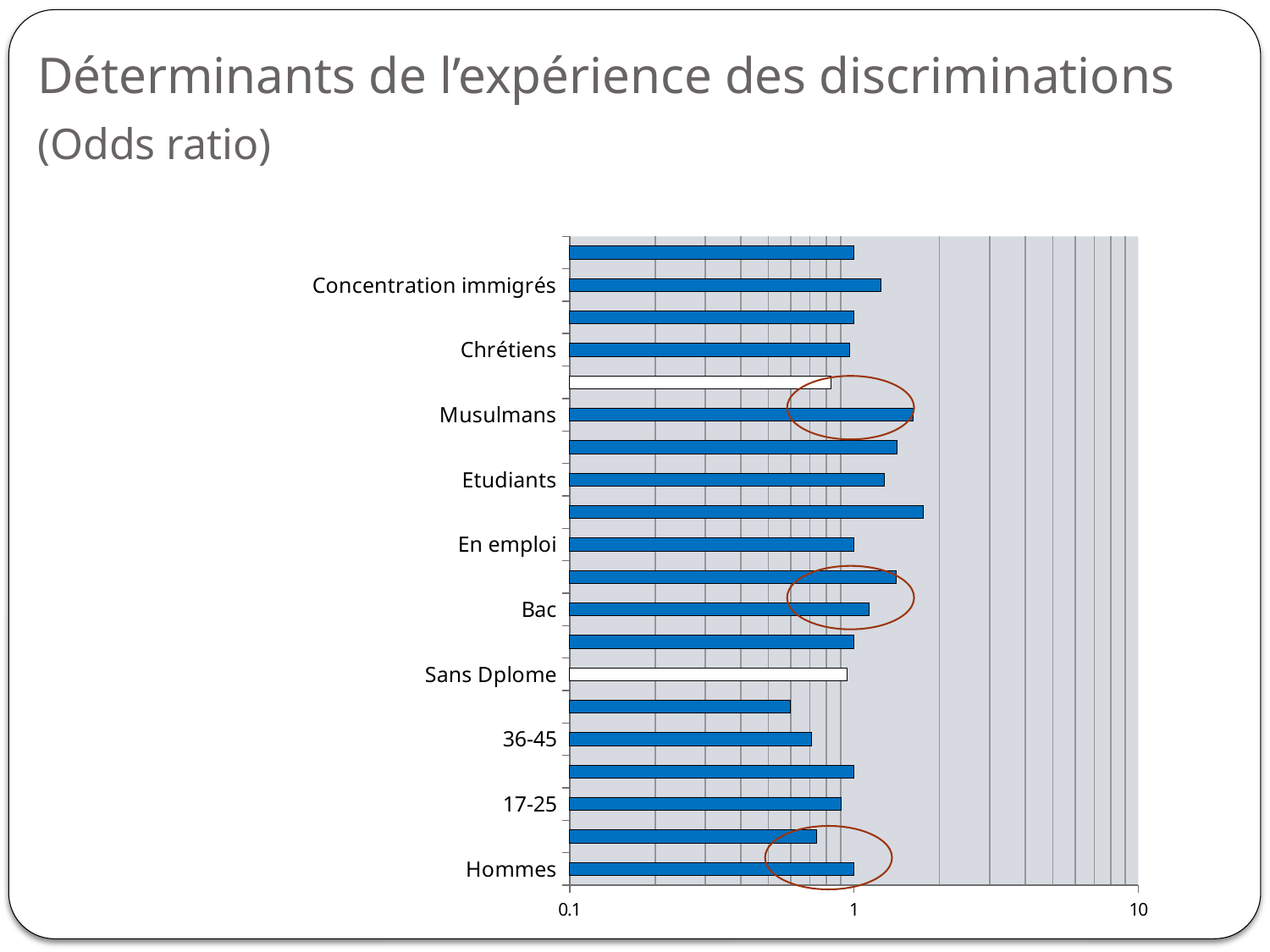
Is the value for Concentration immigrés greater or less than 1? greater Which has the larger value, Etudiants or 36-45? Etudiants What kind of chart is shown on the slide? bar chart Among the labelled categories, which has the lowest value? 36-45 Among the labelled categories, which has the highest value? Musulmans Is the value for Etudiants greater or less than 1? greater What is the maximum value shown on the horizontal axis? 10 What is the title of the slide? Déterminants de l'expérience des discriminations (Odds ratio) Which has the larger value, Musulmans or Chrétiens? Musulmans Is the value for Musulmans greater or less than 1? greater How many category labels are shown on the vertical axis? 10